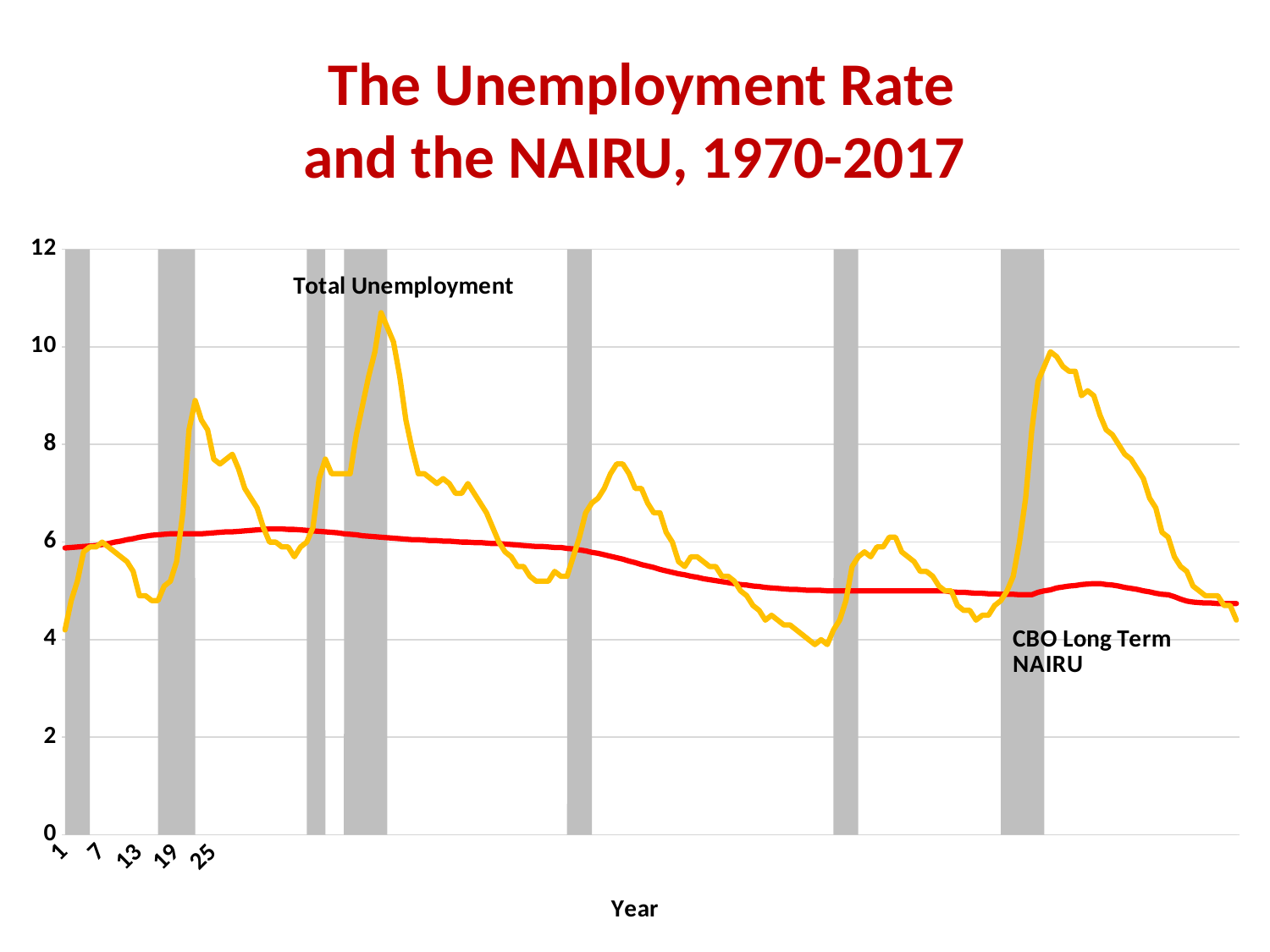
Does the CBO Long Term NAIRU line generally rise or fall from the left side of the chart to the right side? Fall Is the highest value of the CBO Long Term NAIRU line greater or less than 8? less What kind of chart is shown on the slide? Line chart What is the label of the horizontal axis? Year Is the lowest value of the Total Unemployment line greater or less than 6? less What is the maximum value shown on the vertical axis? 12 What is the title of the chart on the slide? The Unemployment Rate and the NAIRU, 1970-2017 Is the CBO Long Term NAIRU value at the far right of the chart greater or less than 6? less Which series reaches the higher peak value, Total Unemployment or CBO Long Term NAIRU? Total Unemployment